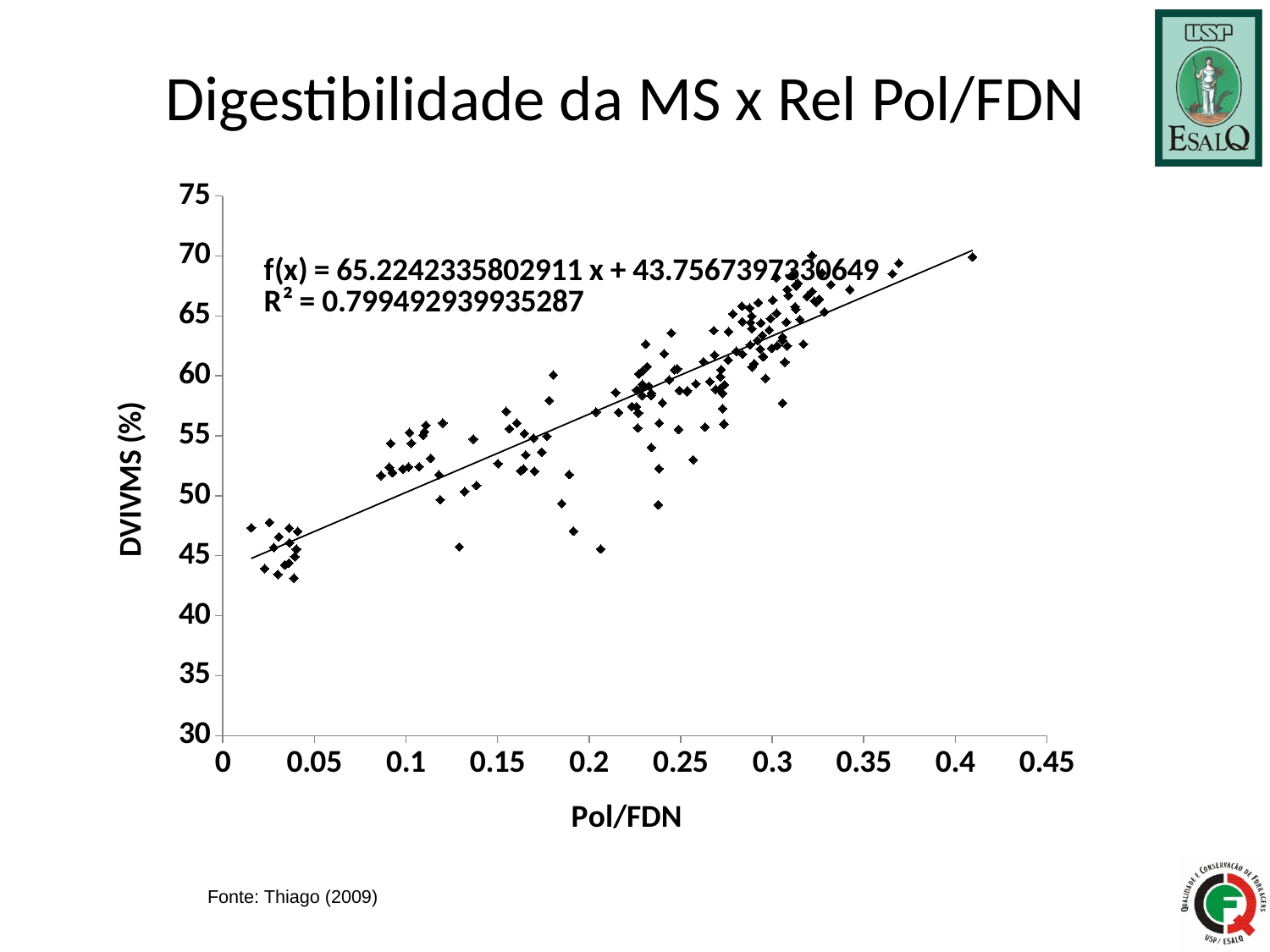
Is the DVIVMS value of the rightmost point (near Pol/FDN = 0.41) greater or less than 65? greater What is the slope of the fitted line f(x) printed on the chart? 65.2242335802911 Do the DVIVMS (%) values rise or fall as Pol/FDN increases along the x axis? rise What is the highest tick value shown on the y axis? 75 What is the R² value printed on the chart? 0.799492939935287 What is the full equation of the fitted line printed on the chart? f(x) = 65.2242335802911 x + 43.7567397330649 What is the label of the y axis? DVIVMS (%) What is the highest tick value shown on the x axis? 0.45 What is the intercept of the fitted line f(x) printed on the chart? 43.7567397330649 What kind of chart is shown on the slide? scatter plot What is the label of the x axis? Pol/FDN What is the lowest tick value shown on the y axis? 30